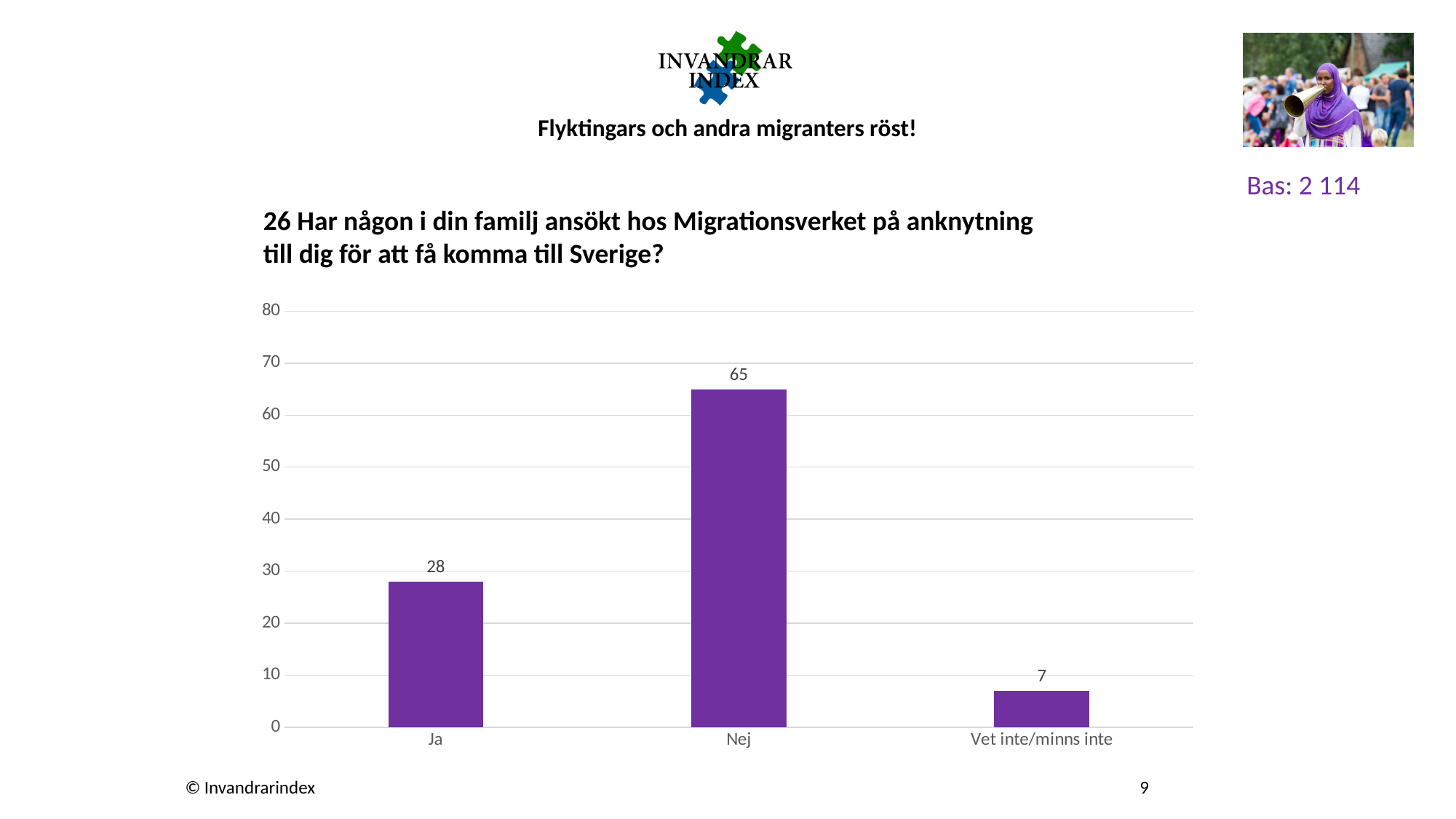
What is the value for Nej? 65 What kind of chart is shown on the slide? bar chart Which category has the lowest value? Vet inte/minns inte What is the base (Bas) shown on the slide? 2 114 What is the value for Ja? 28 Is the value for Nej greater or less than 60? greater What is the value for Vet inte/minns inte? 7 Which category has the highest value? Nej Which is larger, the value for Ja or the value for Nej? Nej What is the difference between the values for Nej and Ja? 37 How many categories are shown on the x axis? 3 What is the difference between the values for Ja and Vet inte/minns inte? 21